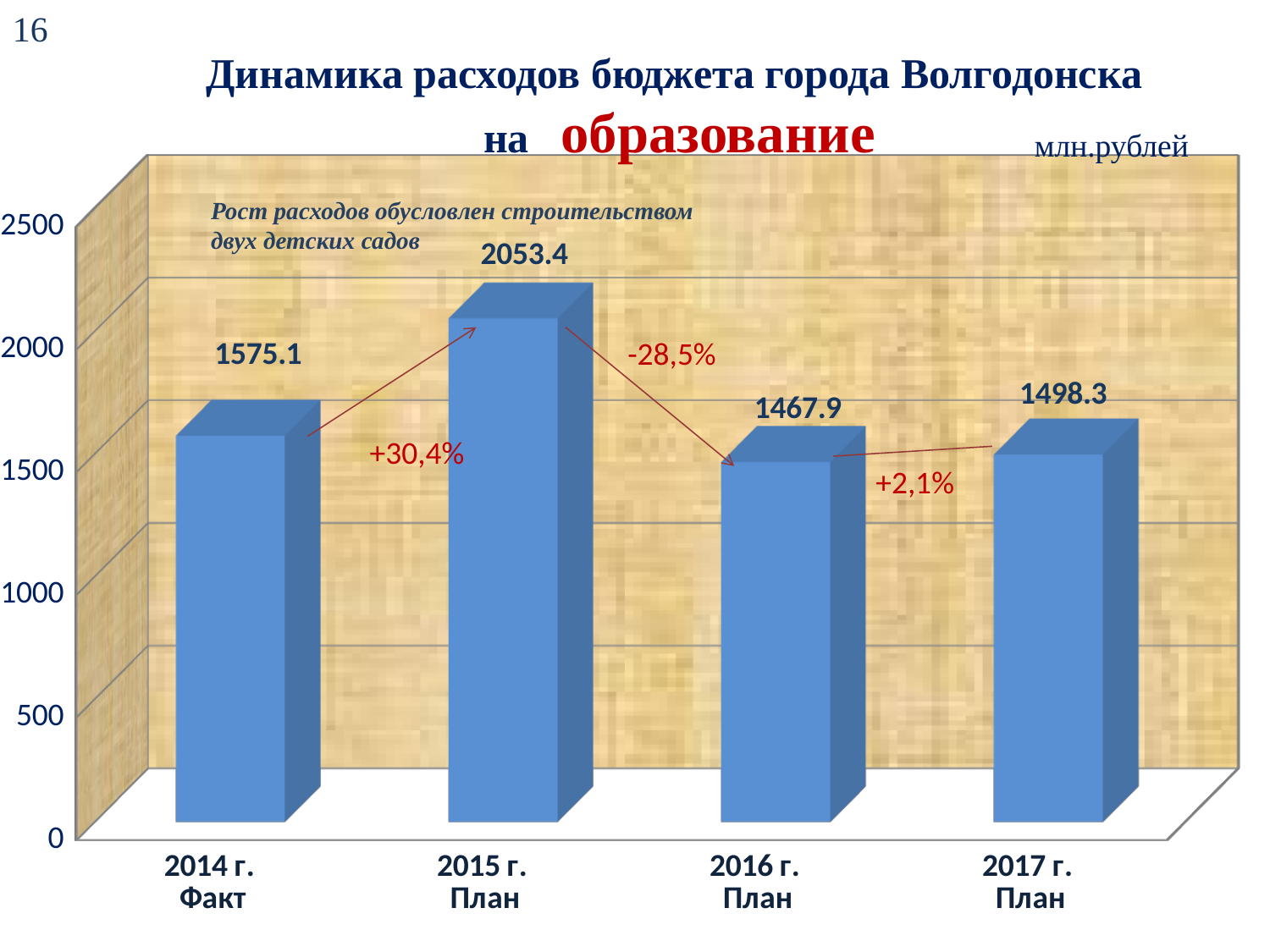
What is the difference between the values for 2015 г. План and 2014 г. Факт? 478.3 Which category has the lowest value? 2016 г. План What unit of measurement is indicated for the chart values? млн.рублей Which category has the highest value? 2015 г. План Which is larger, the value for 2014 г. Факт or the value for 2017 г. План? 2014 г. Факт What is the value for 2015 г. План? 2053.4 What is the difference between the values for 2017 г. План and 2016 г. План? 30.4 What is the value for 2017 г. План? 1498.3 How many categories are shown on the x axis? 4 What is the value for 2016 г. План? 1467.9 What is the value for 2014 г. Факт? 1575.1 What kind of chart is shown on the slide? Bar chart